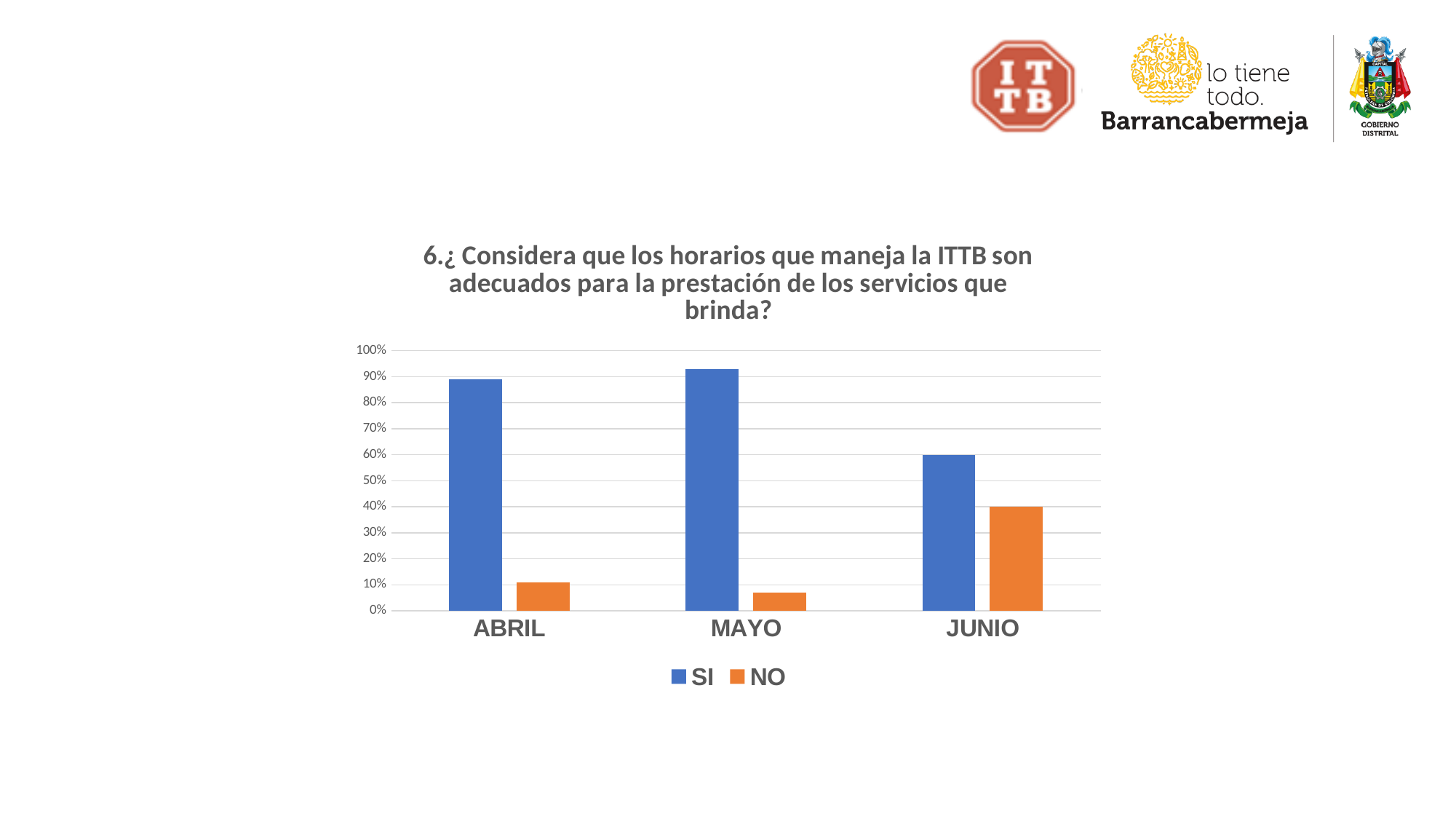
Which colour represents the NO series in the legend? orange Is the value for SI in ABRIL greater or less than 80%? greater Which is larger in JUNIO, SI or NO? SI Which month has the lowest value for NO? MAYO Which is larger, the NO value for ABRIL or the NO value for JUNIO? JUNIO Which month has the highest value for SI? MAYO Is the value for NO in MAYO greater or less than 10%? less Which month has the highest value for NO? JUNIO How many series does the legend list? 2 What kind of chart is shown on the slide? bar chart Which month has the lowest value for SI? JUNIO How many months are shown on the x axis? 3